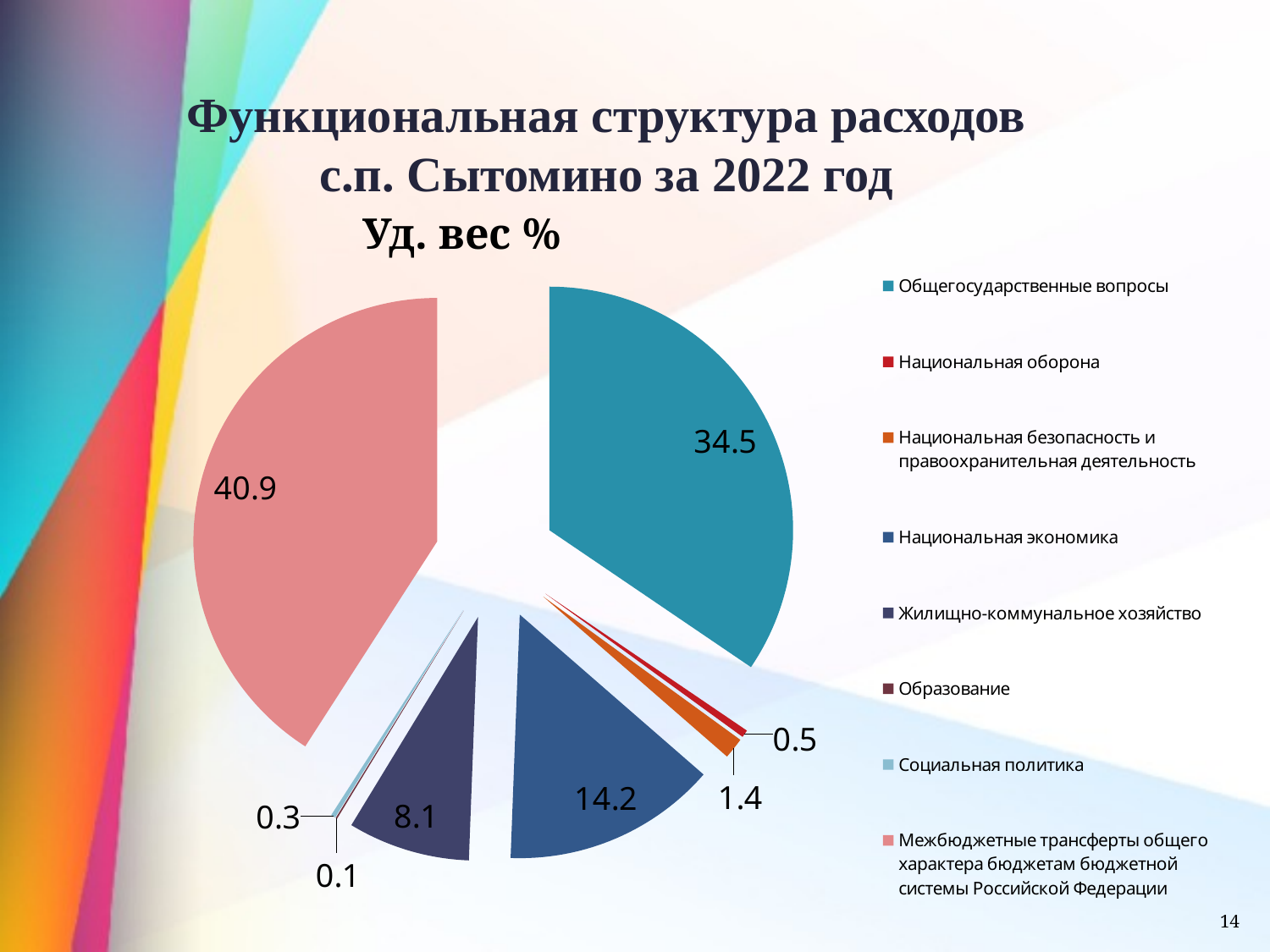
How many categories does the legend list? 8 What is the value for Межбюджетные трансферты общего характера бюджетам бюджетной системы Российской Федерации? 40.9 What is the value for Общегосударственные вопросы? 34.5 What kind of chart is shown on the slide? pie chart What is the value for Национальная безопасность и правоохранительная деятельность? 1.4 What is the value for Жилищно-коммунальное хозяйство? 8.1 What is the difference between the values for Межбюджетные трансферты общего характера and Общегосударственные вопросы? 6.4 What is the title of the slide above the chart? Функциональная структура расходов с.п. Сытомино за 2022 год What is the value for Национальная экономика? 14.2 Which is larger, Национальная экономика or Жилищно-коммунальное хозяйство? Национальная экономика What is the value for Национальная оборона? 0.5 Which category has the largest share of the pie? Межбюджетные трансферты общего характера бюджетам бюджетной системы Российской Федерации